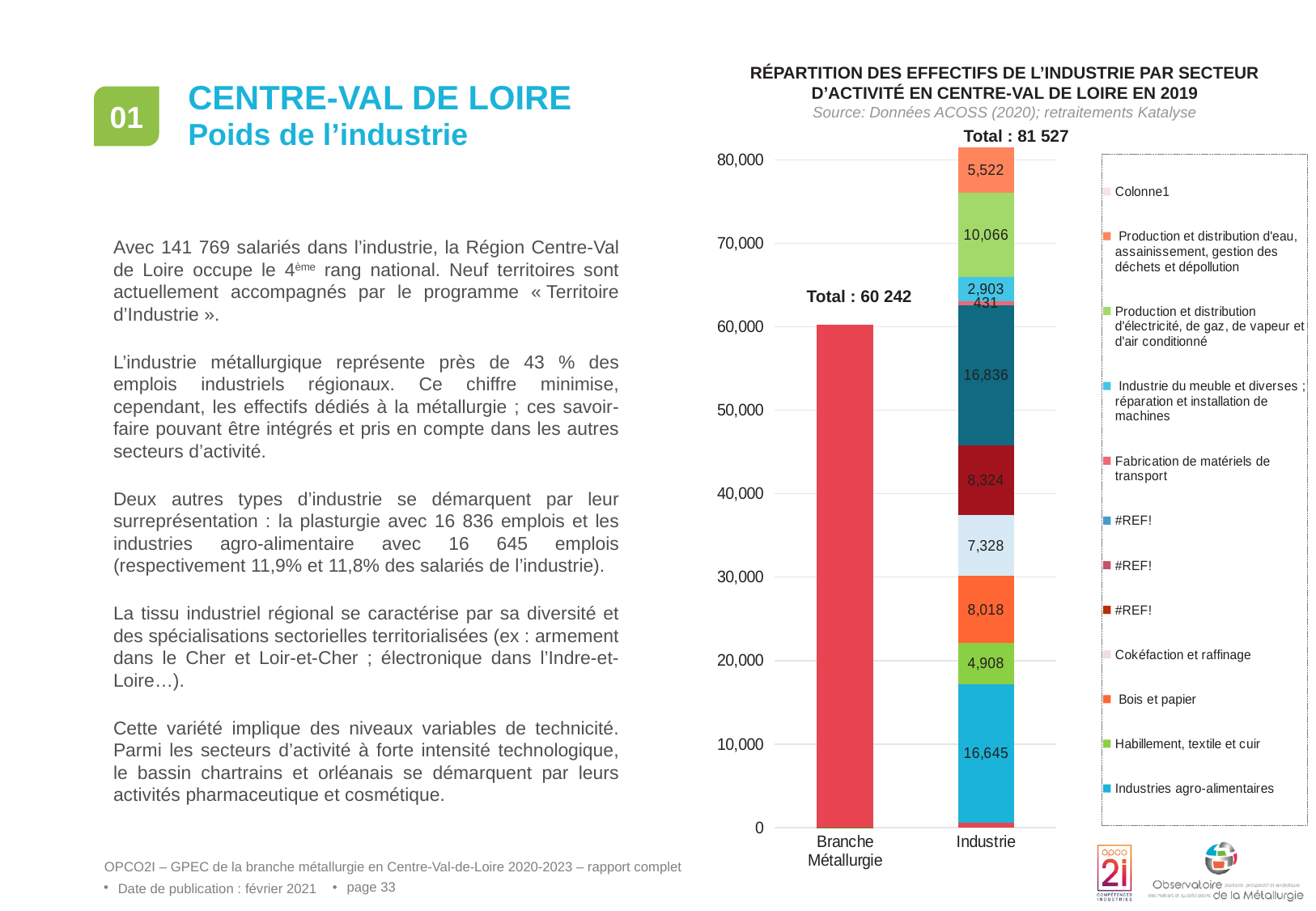
What is the value of the Habillement, textile et cuir segment in the Industrie bar? 4,908 What is the value of the Production et distribution d'électricité, de gaz, de vapeur et d'air conditionné segment in the Industrie bar? 10,066 How many categories are shown on the x axis of the chart? 2 What is the total shown for the Branche Métallurgie bar? 60 242 What is the difference between the Industrie total and the Branche Métallurgie total? 21 285 What is the value of the topmost segment of the Industrie bar? 5,522 What kind of chart is shown on the slide? Stacked bar chart Is the value of the Branche Métallurgie bar greater or less than 50,000? greater What is the value of the Industries agro-alimentaires segment in the Industrie bar? 16,645 What is the value of the Bois et papier segment in the Industrie bar? 8,018 What is the total shown above the Industrie bar? 81 527 Which bar is taller, Branche Métallurgie or Industrie? Industrie